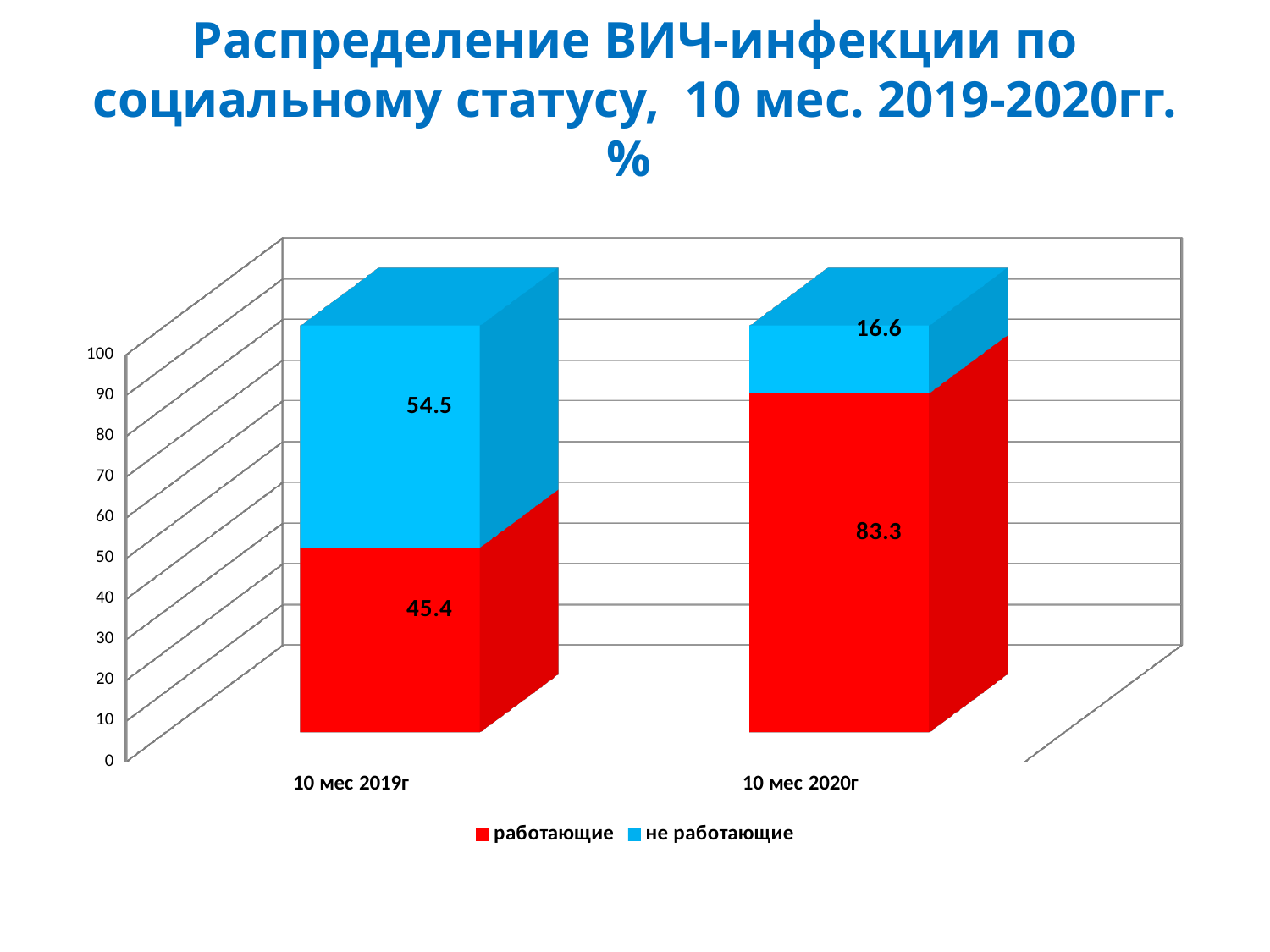
Which category has the higher value for работающие? 10 мес 2020г What is the value for не работающие in 10 мес 2019г? 54.5 What is the difference between the работающие values for 10 мес 2020г and 10 мес 2019г? 37.9 What is the total of the stacked bar for 10 мес 2019г? 99.9 How many series does the legend list? 2 What is the value for не работающие in 10 мес 2020г? 16.6 Which is larger in 10 мес 2019г: работающие or не работающие? не работающие What is the value for работающие in 10 мес 2019г? 45.4 What is the value for работающие in 10 мес 2020г? 83.3 How many categories are shown on the x axis? 2 What kind of chart is shown on the slide? Stacked bar chart Which category has the lower value for не работающие? 10 мес 2020г